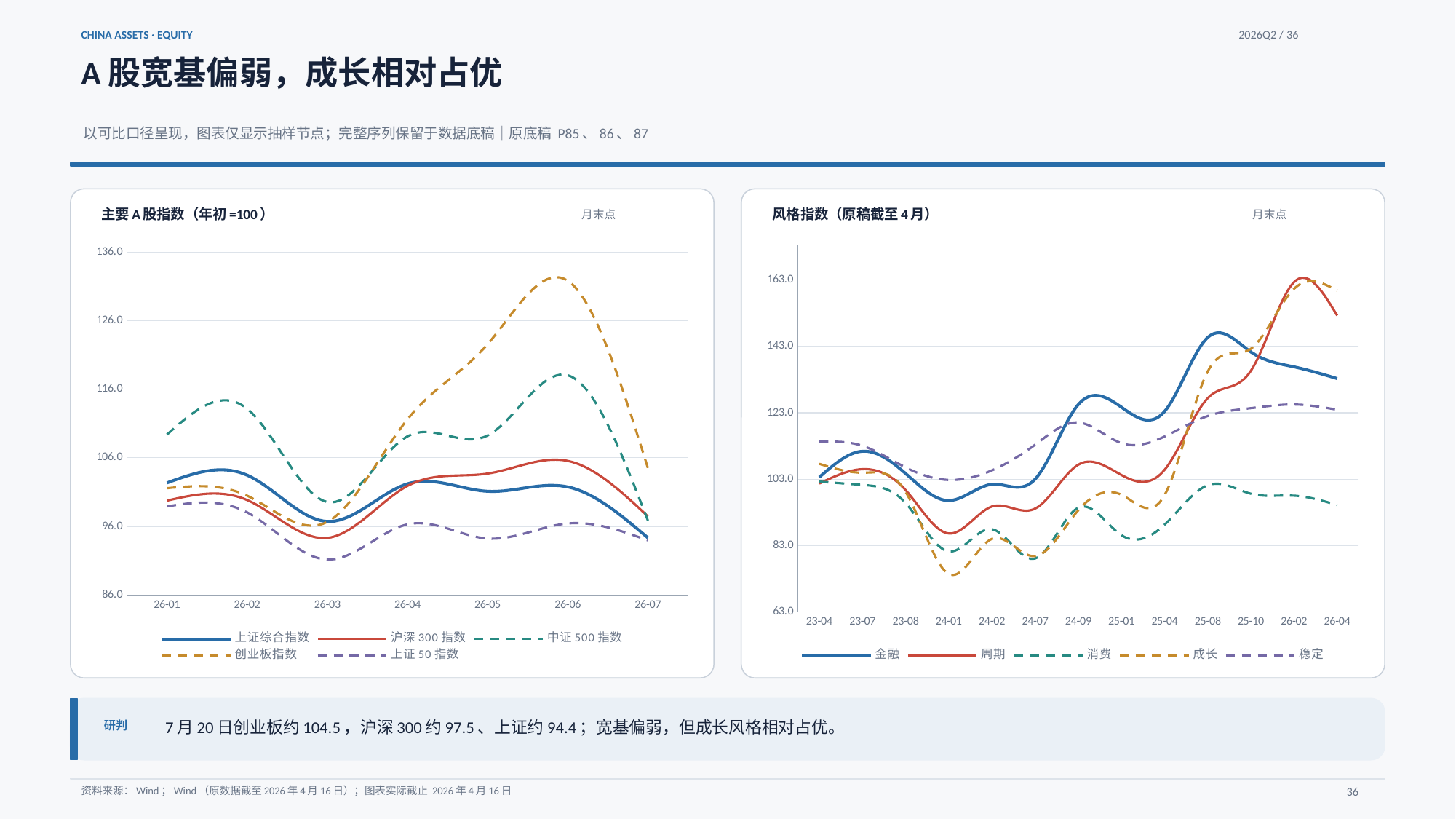
In the left chart 主要 A 股指数（年初 =100）, which series has the highest value at 26-06? 创业板指数 What kind of chart is the left chart titled 主要 A 股指数（年初 =100）? line chart In the left chart 主要 A 股指数（年初 =100）, how many series does the legend list? 5 In the left chart 主要 A 股指数（年初 =100）, is the value for 创业板指数 at 26-06 greater or less than 126.0? greater In the right chart 风格指数（原稿截至 4 月）, how many series does the legend list? 5 In the right chart 风格指数（原稿截至 4 月）, does the 金融 series rise or fall overall from 23-04 to 26-04? rise In the left chart 主要 A 股指数（年初 =100）, is the value for 上证 50 指数 at 26-03 greater or less than 96.0? less In the right chart 风格指数（原稿截至 4 月）, is the value for 成长 at 24-01 greater or less than 83.0? less In the right chart 风格指数（原稿截至 4 月）, how many points are shown on the x axis? 13 In the right chart 风格指数（原稿截至 4 月）, which series has the lowest value at 26-04? 消费 In the left chart 主要 A 股指数（年初 =100）, how many points are shown on the x axis? 7